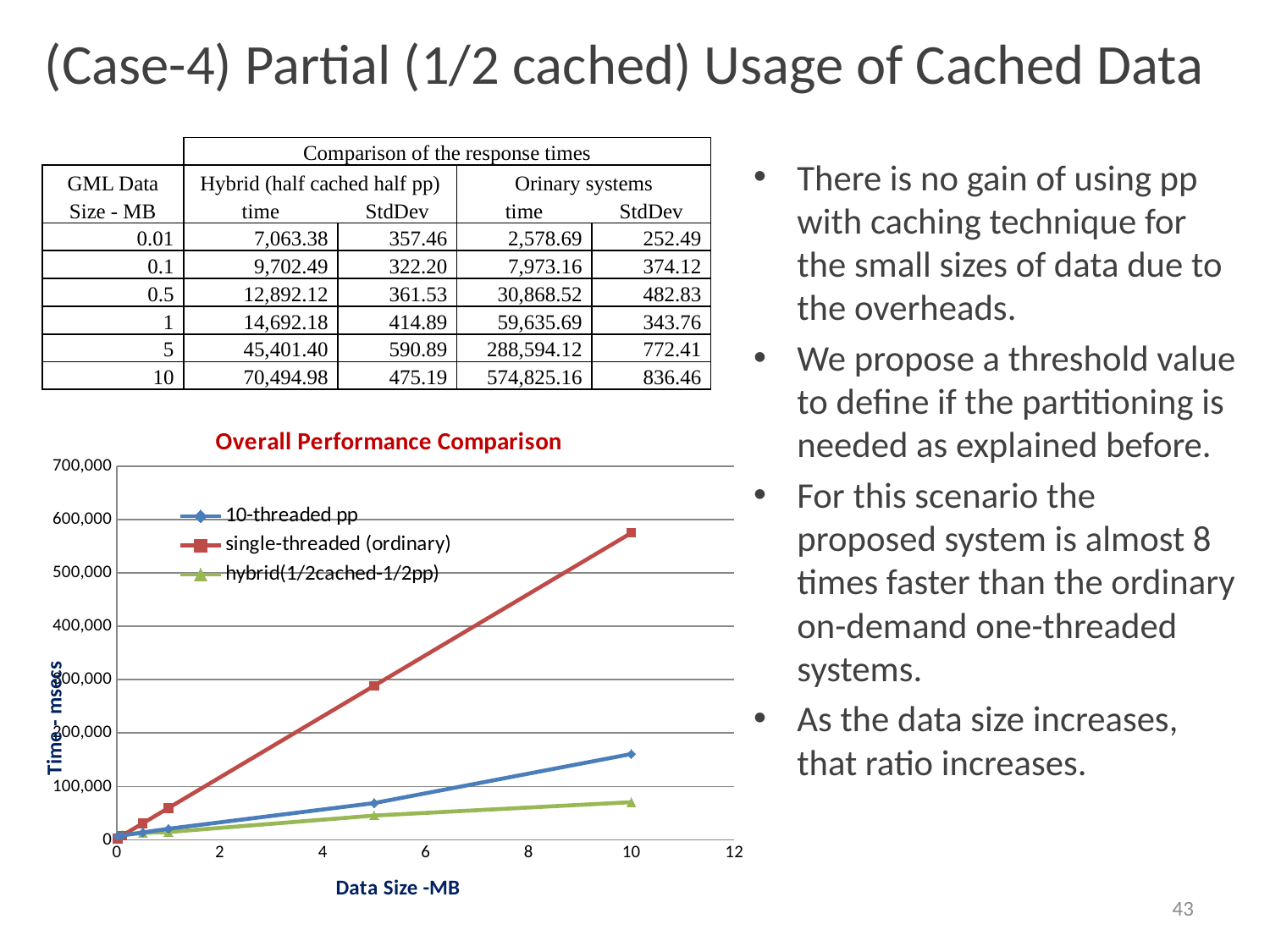
In the 'Overall Performance Comparison' chart, is the value for single-threaded (ordinary) at 10 MB greater or less than 500,000? greater In the 'Overall Performance Comparison' chart, is the value for 10-threaded pp at 10 MB greater or less than 100,000? greater In the 'Overall Performance Comparison' chart, do the values of the single-threaded (ordinary) series rise or fall as data size increases? rise What kind of chart is the 'Overall Performance Comparison' chart? line chart In the 'Overall Performance Comparison' chart, at 10 MB, which is larger: single-threaded (ordinary) or 10-threaded pp? single-threaded (ordinary) What is the x-axis label of the 'Overall Performance Comparison' chart? Data Size -MB In the 'Overall Performance Comparison' chart, is the value for 10-threaded pp at 10 MB greater or less than 200,000? less In the 'Overall Performance Comparison' chart, which series reaches the highest value? single-threaded (ordinary) What is the y-axis label of the 'Overall Performance Comparison' chart? Time - msecs In the 'Overall Performance Comparison' chart, which series has the lowest value at a data size of 10 MB? hybrid(1/2cached-1/2pp) How many series does the legend of the 'Overall Performance Comparison' chart list? 3